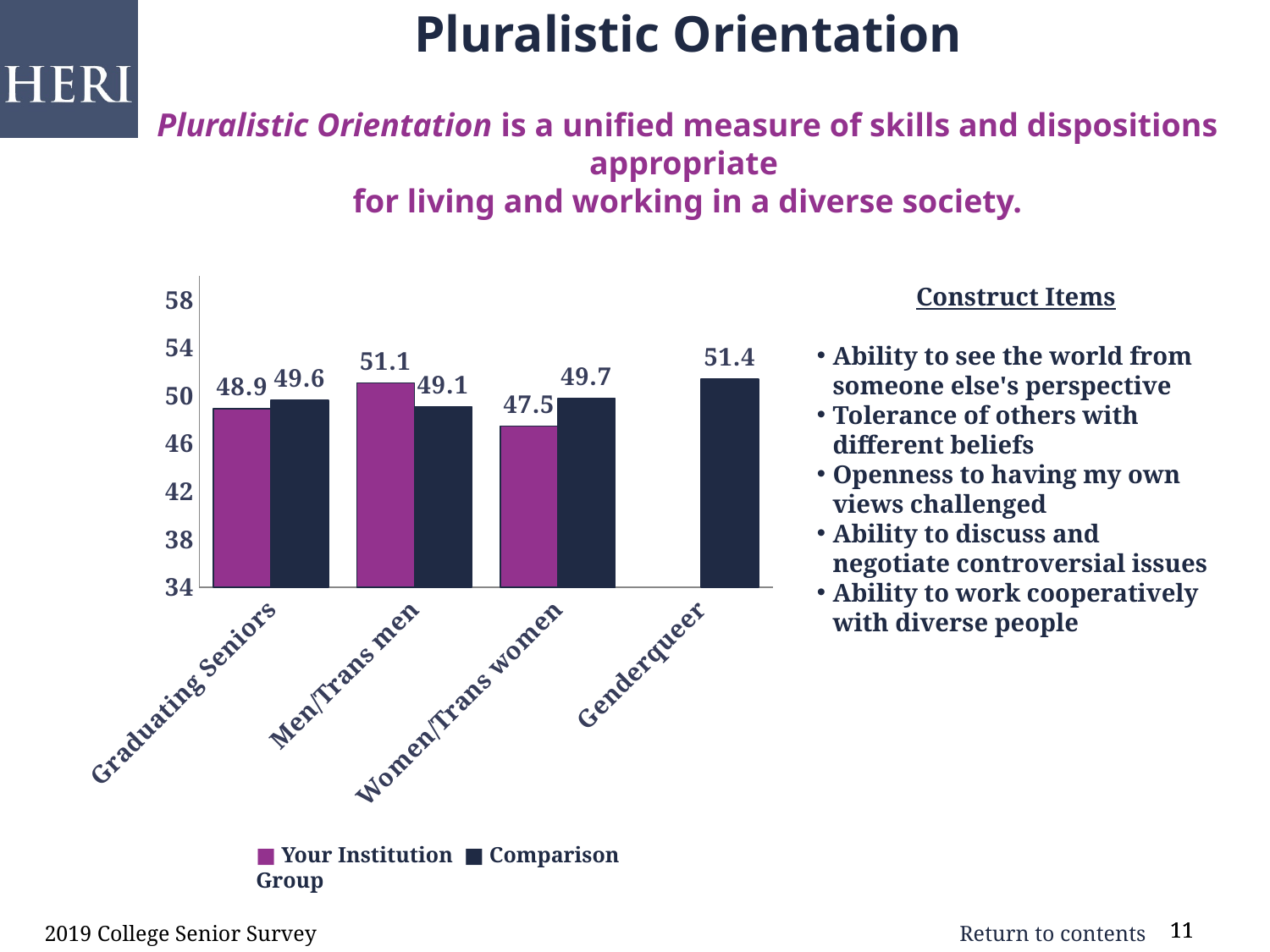
What is the Your Institution value for Graduating Seniors? 48.9 What is the Comparison Group value for Genderqueer? 51.4 How many categories are shown on the x axis? 4 What is the difference between the Comparison Group and Your Institution values for Women/Trans women? 2.2 Which category has the lowest Your Institution value? Women/Trans women Which category has the highest Your Institution value? Men/Trans men How many series does the legend list? 2 Which category has the highest Comparison Group value? Genderqueer What kind of chart is shown on the slide? Bar chart What is the difference between the Your Institution and Comparison Group values for Men/Trans men? 2.0 For Graduating Seniors, which is larger: the Your Institution value or the Comparison Group value? Comparison Group What is the Comparison Group value for Women/Trans women? 49.7